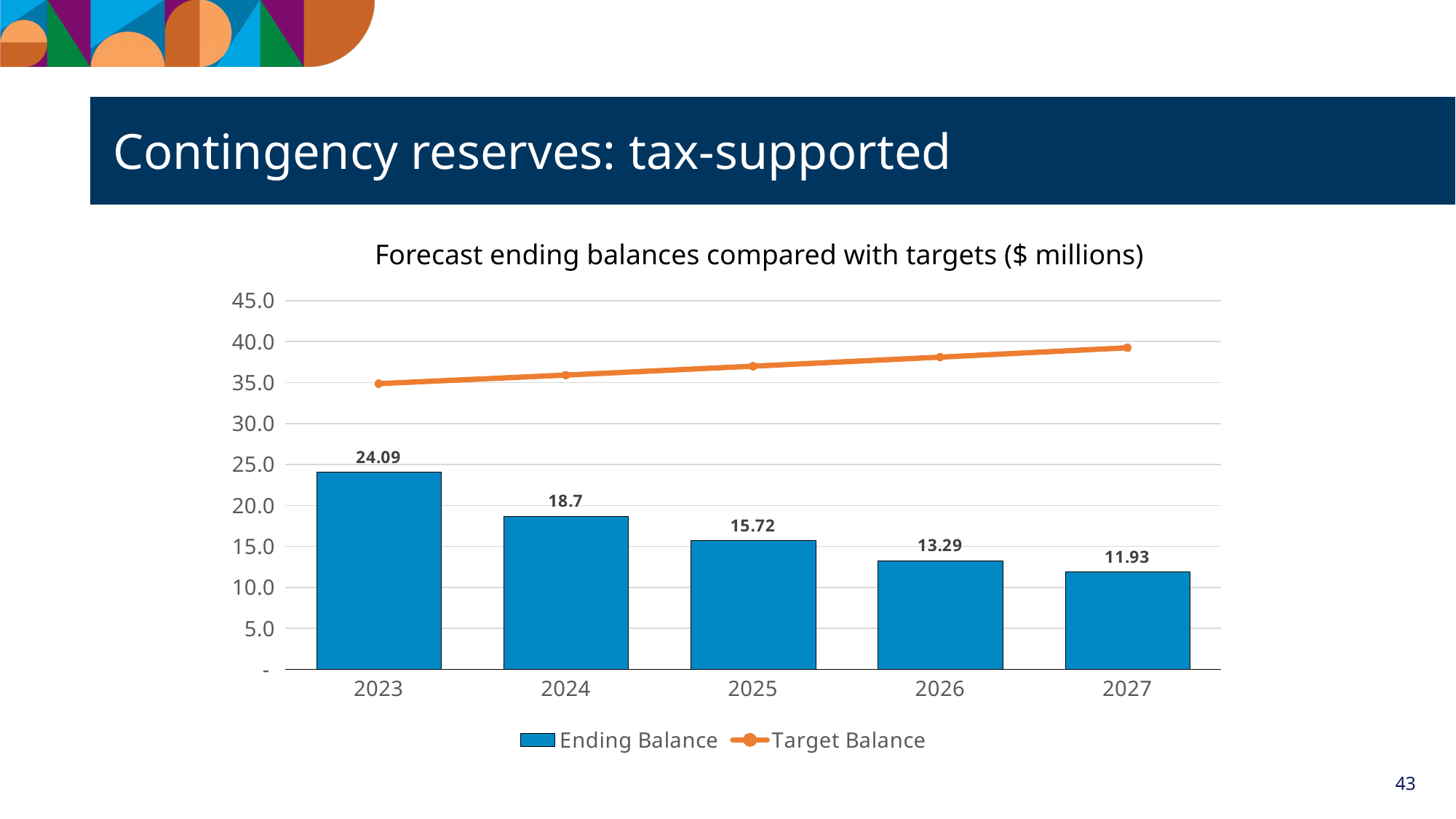
How many series does the legend list? 2 Is the Target Balance for 2023 greater or less than 30.0? greater What is the difference between the Ending Balance in 2023 and in 2024? 5.39 Is the Target Balance for 2027 greater or less than 35.0? greater Which is larger, the Ending Balance for 2025 or for 2026? 2025 What is the Ending Balance for 2025? 15.72 What is the Ending Balance for 2027? 11.93 Which year has the highest Ending Balance? 2023 What is the Ending Balance for 2023? 24.09 How many years are shown on the x axis? 5 Does the Ending Balance rise or fall from 2023 to 2027? fall Which year has the lowest Ending Balance? 2027